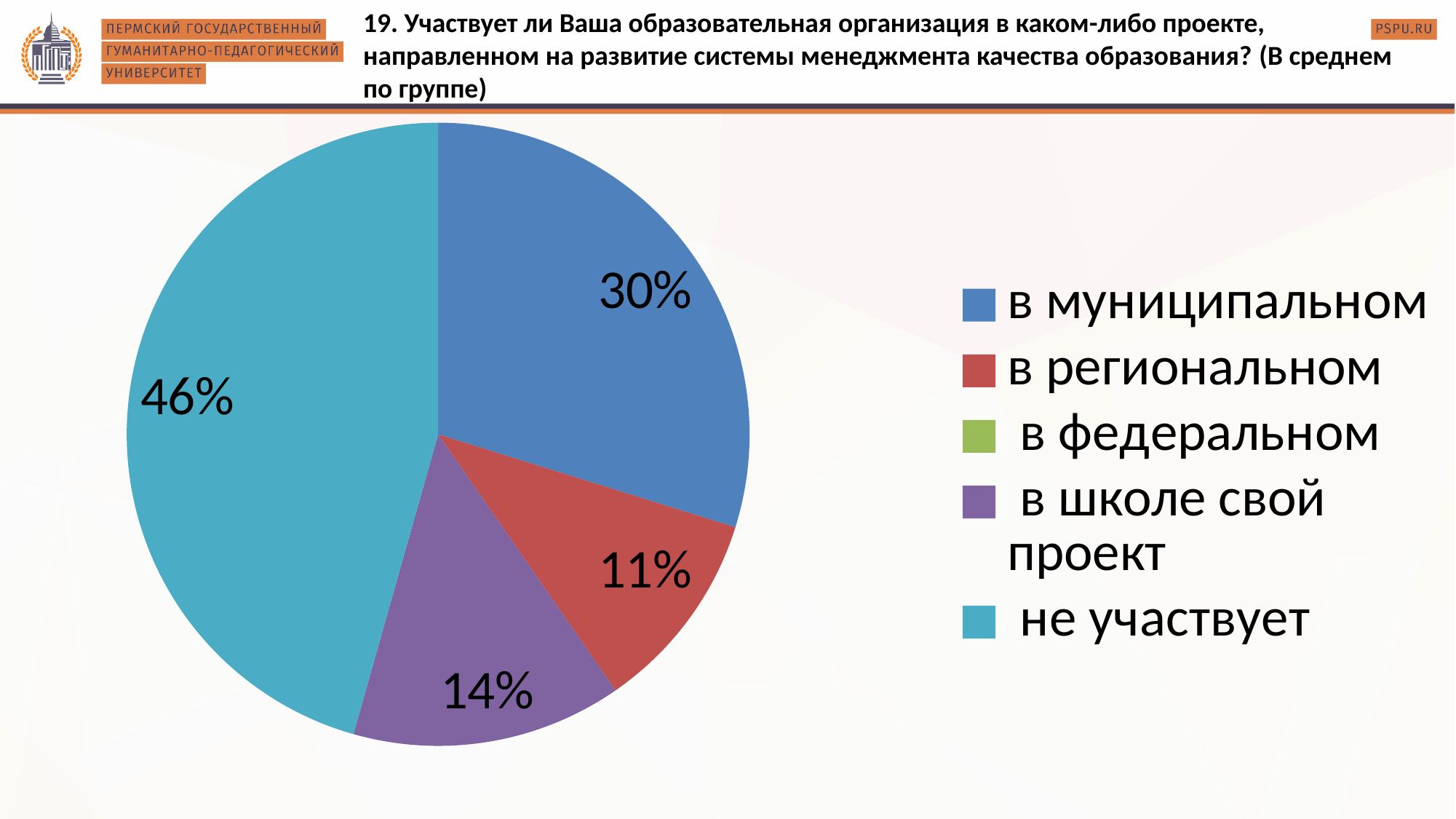
What share of the pie is labelled "не участвует"? 46% How many entries does the legend list? 5 Which category has the largest slice of the pie? не участвует Among the slices with printed labels, which category has the smallest share? в региональном What percentage is shown for "в региональном"? 11% What percentage is shown for "в муниципальном"? 30% What colour is the slice for "не участвует"? teal (light blue) What percentage is shown for "в школе свой проект"? 14% Which is larger: the share for "в школе свой проект" or for "в региональном"? в школе свой проект Which legend entry is shown in red? в региональном What kind of chart is shown on the slide? pie chart What is the difference in percentage points between "не участвует" and "в муниципальном"? 16